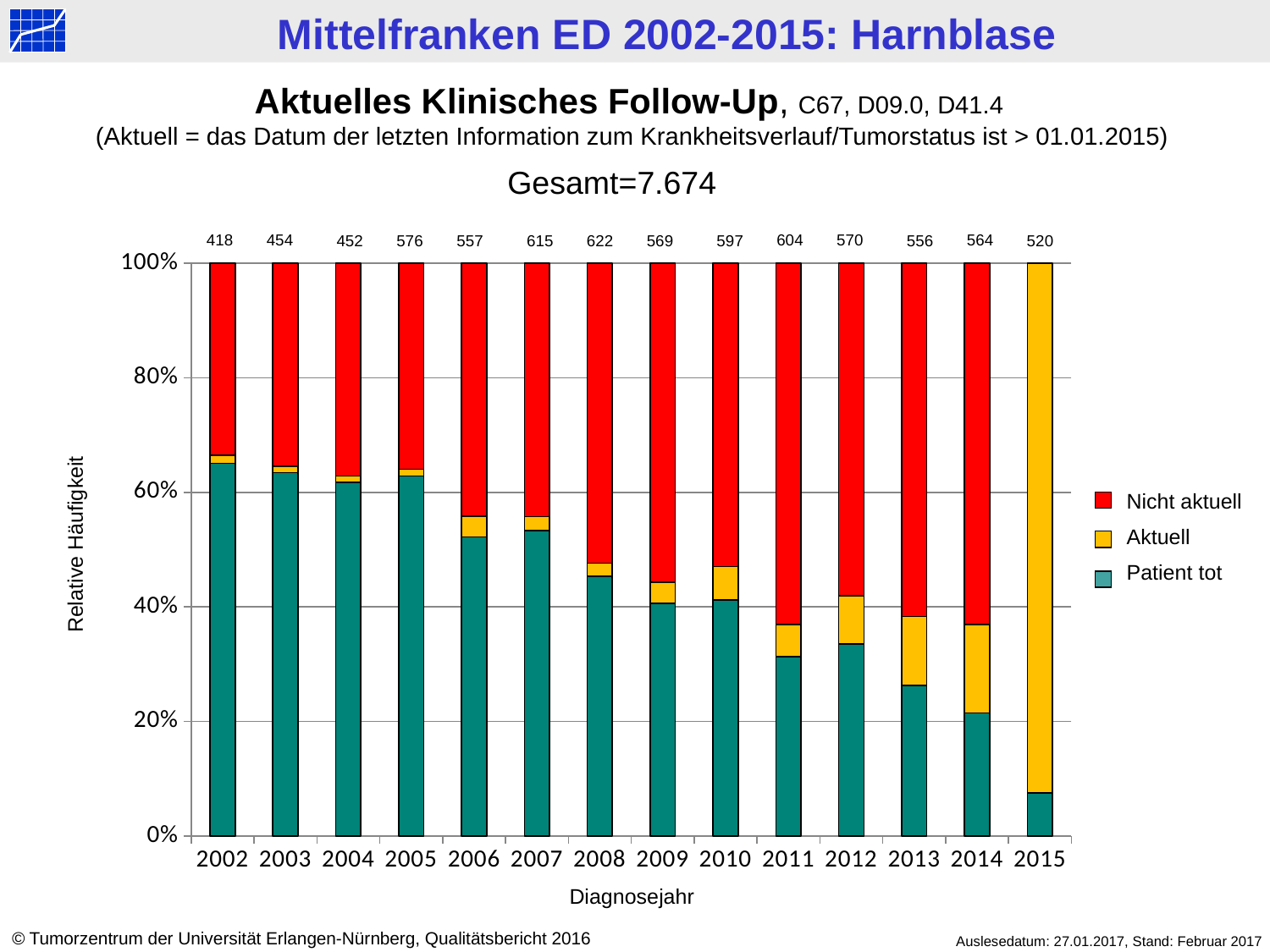
What is the number printed above the bar for 2008? 622 What is the difference between the numbers printed above the bars for 2008 and 2002? 204 What is the number printed above the bar for 2002? 418 How many diagnosis years are shown on the x axis? 14 Which diagnosis year has the lowest number printed above its bar? 2002 What is the number printed above the bar for 2015? 520 Is the 'Patient tot' share for 2015 greater or less than 20%? less Which year has the larger number printed above its bar, 2005 or 2006? 2005 Does the 'Patient tot' share generally rise or fall from 2002 to 2015? fall How many series does the legend list? 3 What kind of chart is shown on the slide? bar chart Which diagnosis year has the highest number printed above its bar? 2008